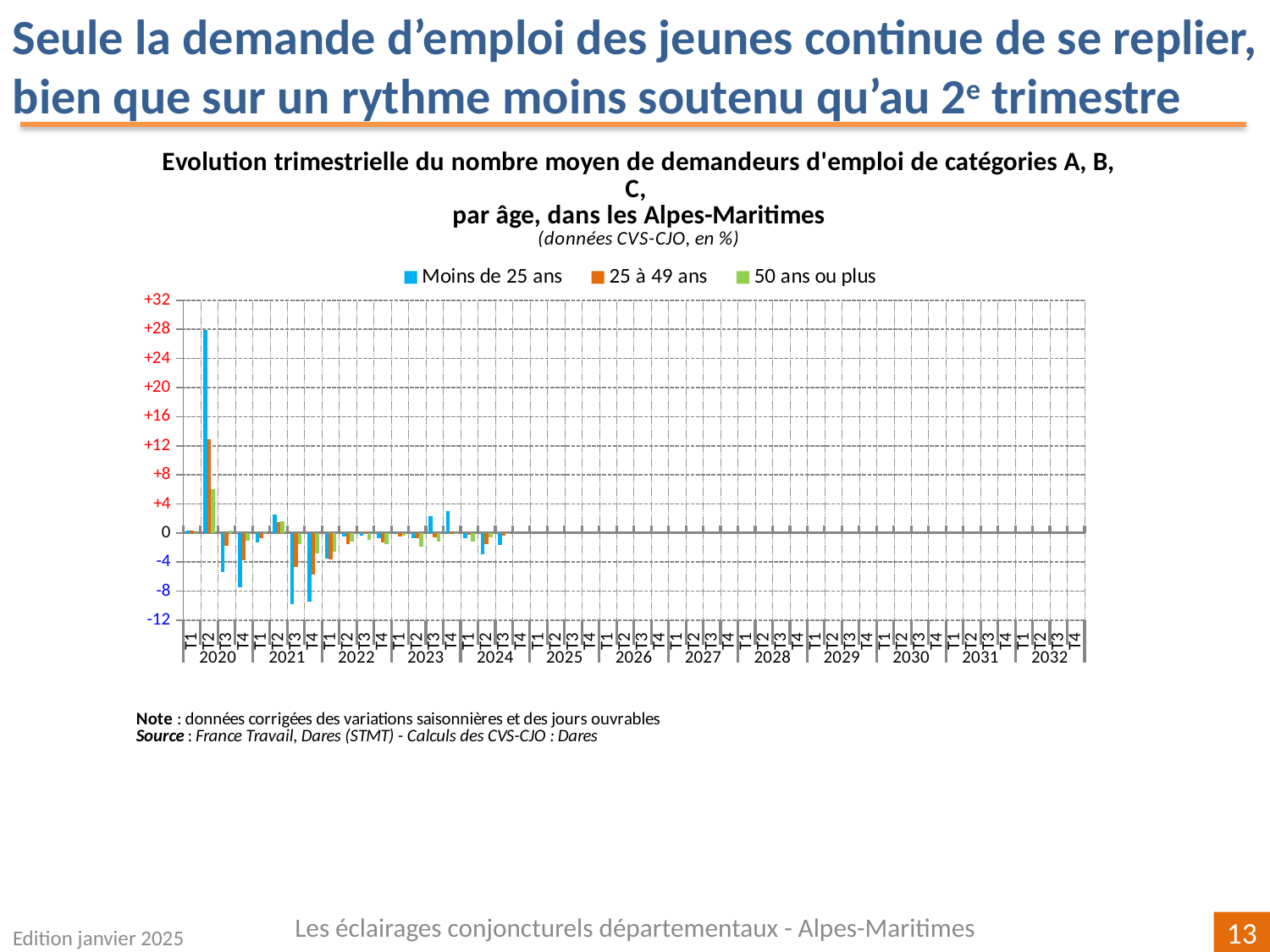
What kind of chart is shown on the slide? bar chart Is the value for Moins de 25 ans in T2 2020 greater or less than +20? greater How many series does the legend list? 3 What is the highest tick value shown on the vertical axis? +32 Which age group has the lowest value in T3 2021? Moins de 25 ans What is the first year shown on the horizontal axis? 2020 Is the value for 25 à 49 ans in T2 2020 greater or less than +8? greater Is the value for Moins de 25 ans in T4 2020 greater or less than -4? less In T2 2020, which is larger: the value for Moins de 25 ans or the value for 25 à 49 ans? Moins de 25 ans Which age group has the highest value in T2 2020? Moins de 25 ans Which colour represents the series 'Moins de 25 ans' in the legend? blue